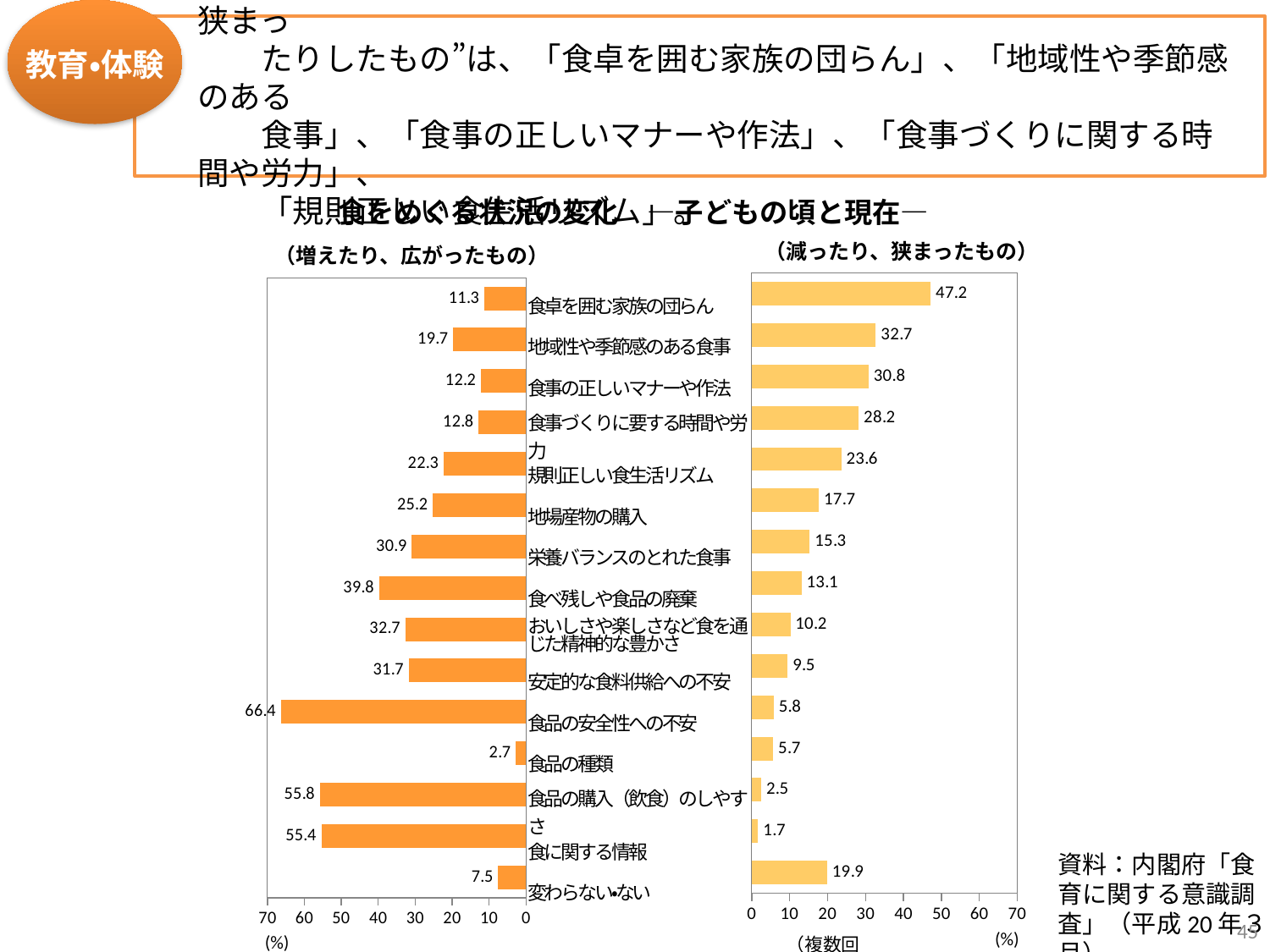
In the left chart (増えたり、広がったもの), which category has the highest value? 食品の安全性への不安 In the left chart (増えたり、広がったもの), which is larger: 食べ残しや食品の廃棄 or 栄養バランスのとれた食事? 食べ残しや食品の廃棄 In the left chart (増えたり、広がったもの), what is the value for 食に関する情報? 55.4 What is the value for 変わらない・ない in the right chart (減ったり、狭まったもの)? 19.9 What kind of chart is shown on the slide? bar chart In the right chart (減ったり、狭まったもの), what is the value for 食卓を囲む家族の団らん? 47.2 In the right chart (減ったり、狭まったもの), is the value for 食事の正しいマナーや作法 greater or less than 20? greater In the left chart (増えたり、広がったもの), what is the value for 食品の安全性への不安? 66.4 In the left chart (増えたり、広がったもの), which category has the lowest value? 食品の種類 In the right chart (減ったり、狭まったもの), what is the difference between 食卓を囲む家族の団らん and 地域性や季節感のある食事? 14.5 In the right chart (減ったり、狭まったもの), which category has the lowest value? 食に関する情報 How many categories are listed in the chart? 15